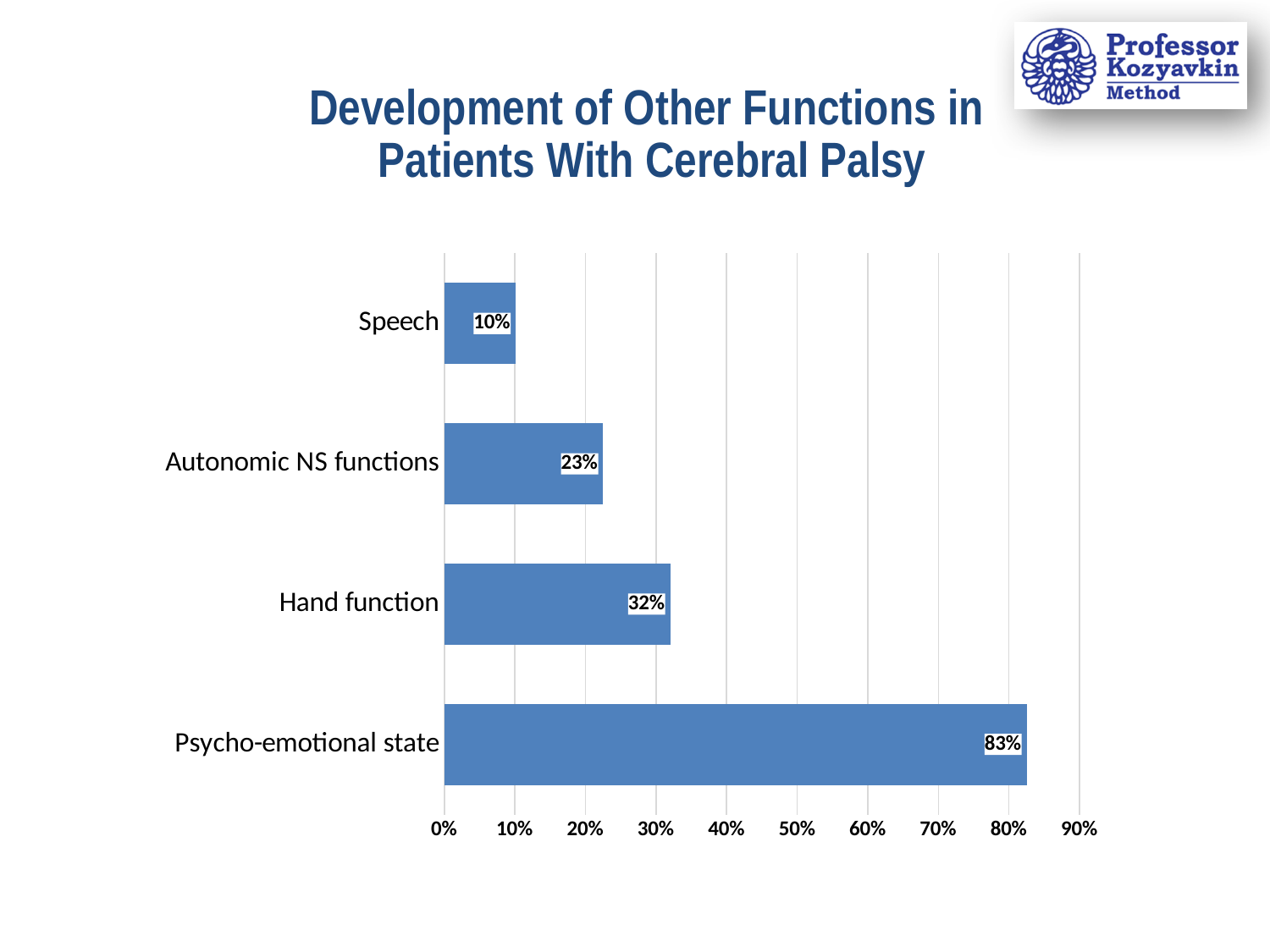
What is the value for Hand function? 32% How many categories are shown in the chart? 4 Is the value for Psycho-emotional state greater or less than 80%? greater What is the value for Autonomic NS functions? 23% Which is larger, the value for Hand function or the value for Autonomic NS functions? Hand function What is the difference between the values for Psycho-emotional state and Hand function? 51% What is the value for Speech? 10% What kind of chart is shown on the slide? Bar chart What is the difference between the values for Autonomic NS functions and Speech? 13% Which category has the highest value? Psycho-emotional state Which category has the lowest value? Speech What is the value for Psycho-emotional state? 83%